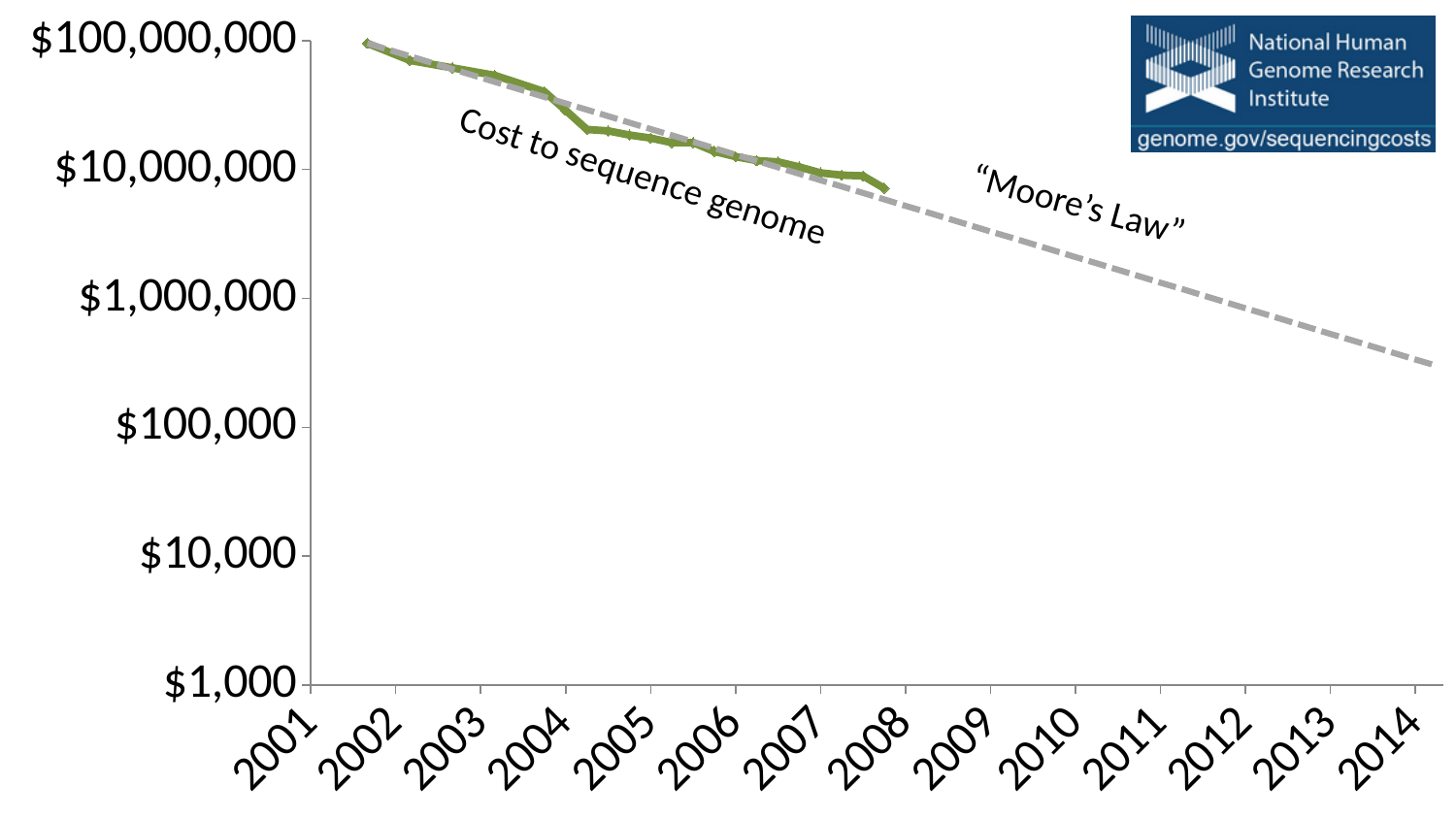
Does the cost to sequence a genome rise or fall over time along the x axis? fall Is the cost to sequence a genome at the end of the green line (around 2008) greater or less than $1,000,000? greater What is the highest value labelled on the y axis? $100,000,000 What kind of chart is shown on the slide? line chart Is the cost to sequence a genome in 2002 greater or less than $10,000,000? greater How many years are labelled on the x axis? 14 Is the "Moore's Law" line at 2014 greater or less than $100,000? greater What is the first year labelled on the x axis? 2001 Which line extends further to the right on the chart, "Cost to sequence genome" or "Moore's Law"? Moore's Law What is the last year labelled on the x axis? 2014 What is the lowest value labelled on the y axis? $1,000